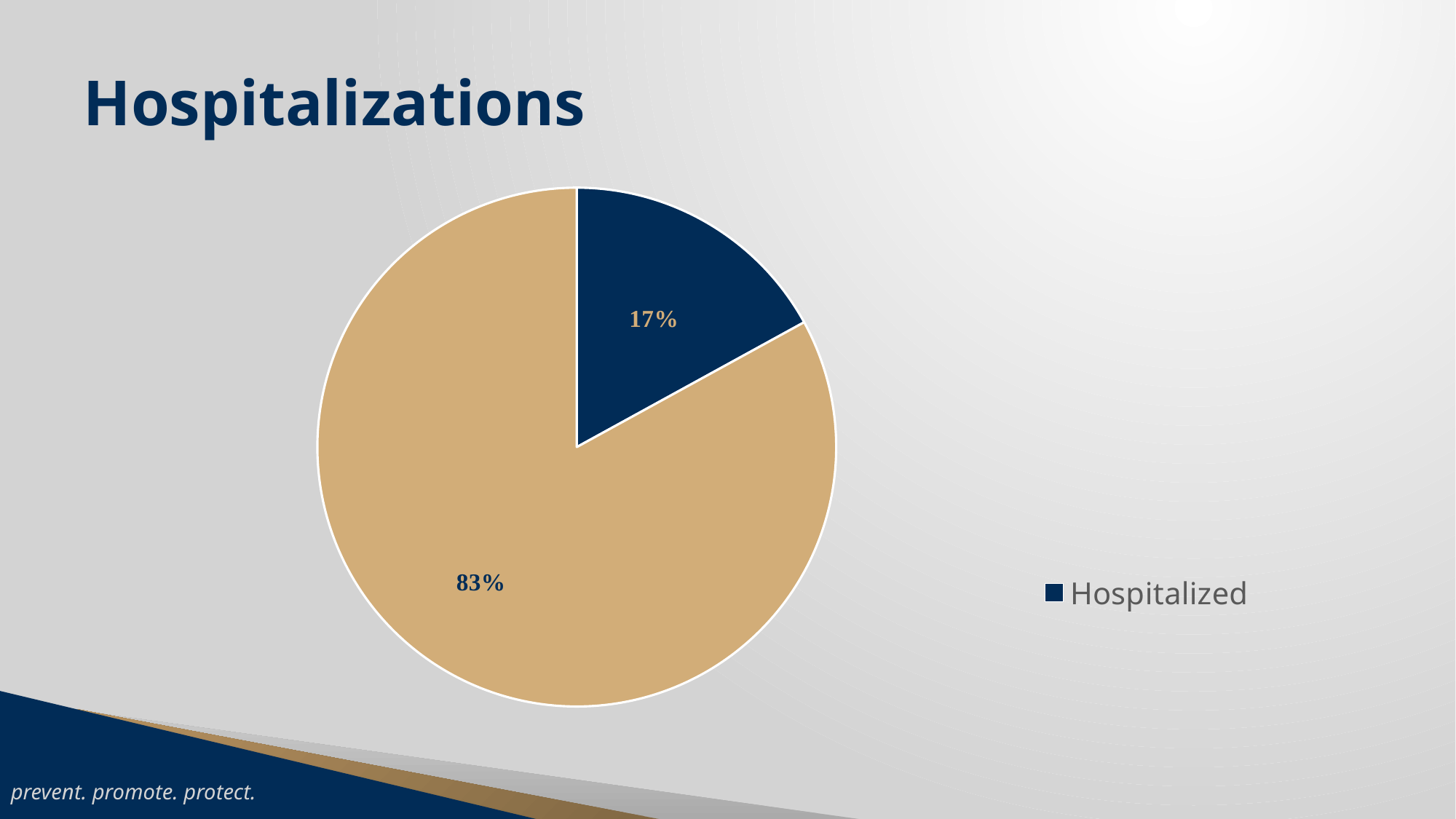
What is the title of the slide containing the pie chart? Hospitalizations What percentage label is shown on the larger, tan-coloured slice of the pie? 83% What is the difference in percentage points between the 83% slice and the Hospitalized slice? 66 How many entries does the legend list? 1 How many slices does the pie chart have? 2 What is the percentage of the largest slice in the pie chart? 83% Which slice is the smallest in the pie chart? Hospitalized What share of the pie does the Hospitalized slice represent? 17% Is the Hospitalized slice larger or smaller than the tan slice? smaller What colour is the Hospitalized slice in the pie chart? dark blue What kind of chart is shown on the slide? pie chart